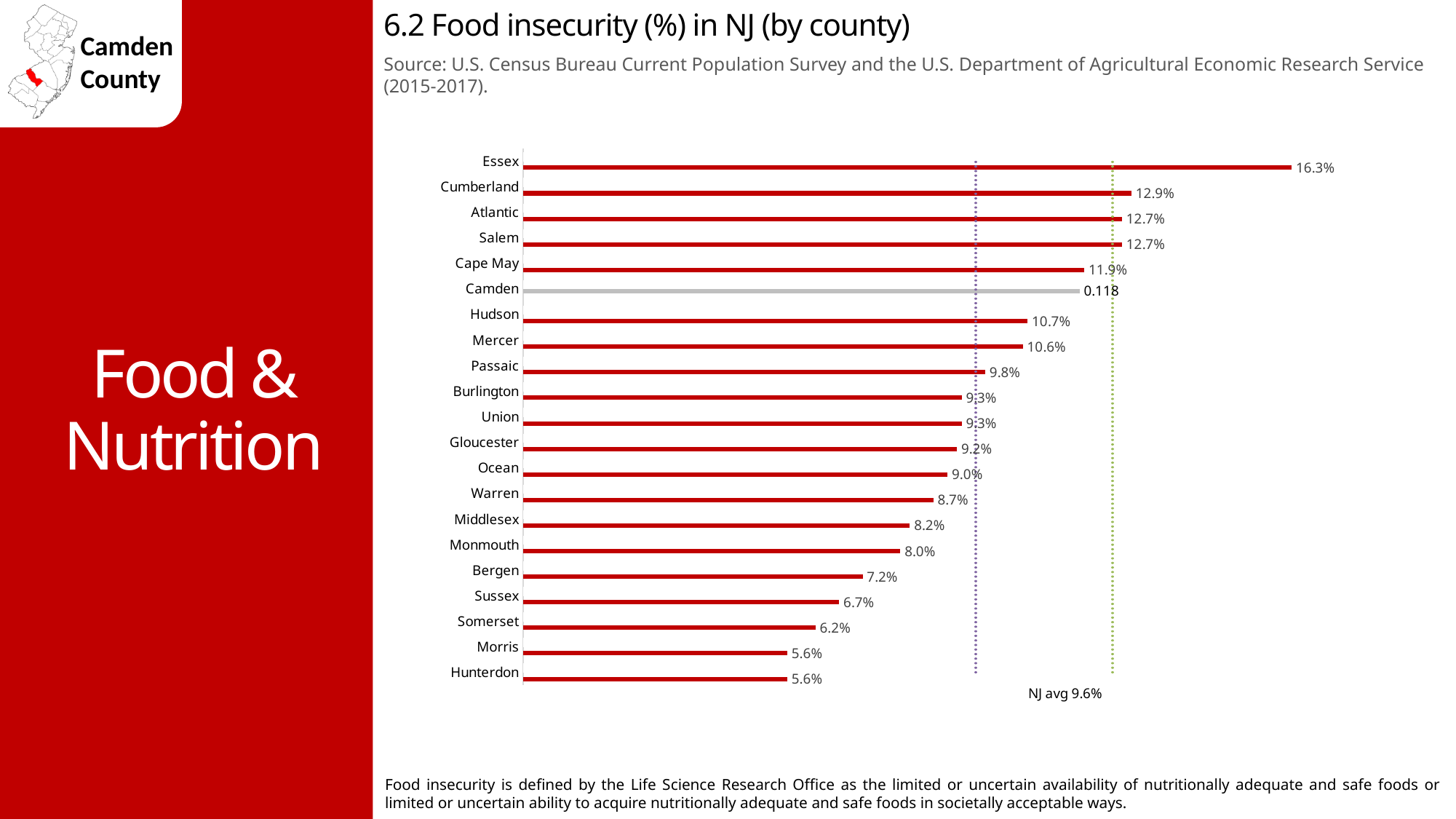
Which county has the highest food insecurity percentage? Essex What kind of chart is used to show food insecurity by county? Bar chart What NJ average value is annotated on the chart? NJ avg 9.6% What is the food insecurity value shown for Essex county? 16.3% What is the food insecurity value shown for Bergen county? 7.2% What is the food insecurity value shown for Hudson county? 10.7% What is the difference in percentage points between Essex (16.3%) and Cumberland (12.9%)? 3.4 How many counties are shown in the chart? 21 What is the difference in percentage points between Bergen (7.2%) and Sussex (6.7%)? 0.5 Which county has a higher food insecurity value, Passaic or Warren? Passaic Which county has a higher food insecurity value, Monmouth or Somerset? Monmouth What value is labeled on the Camden bar? 0.118